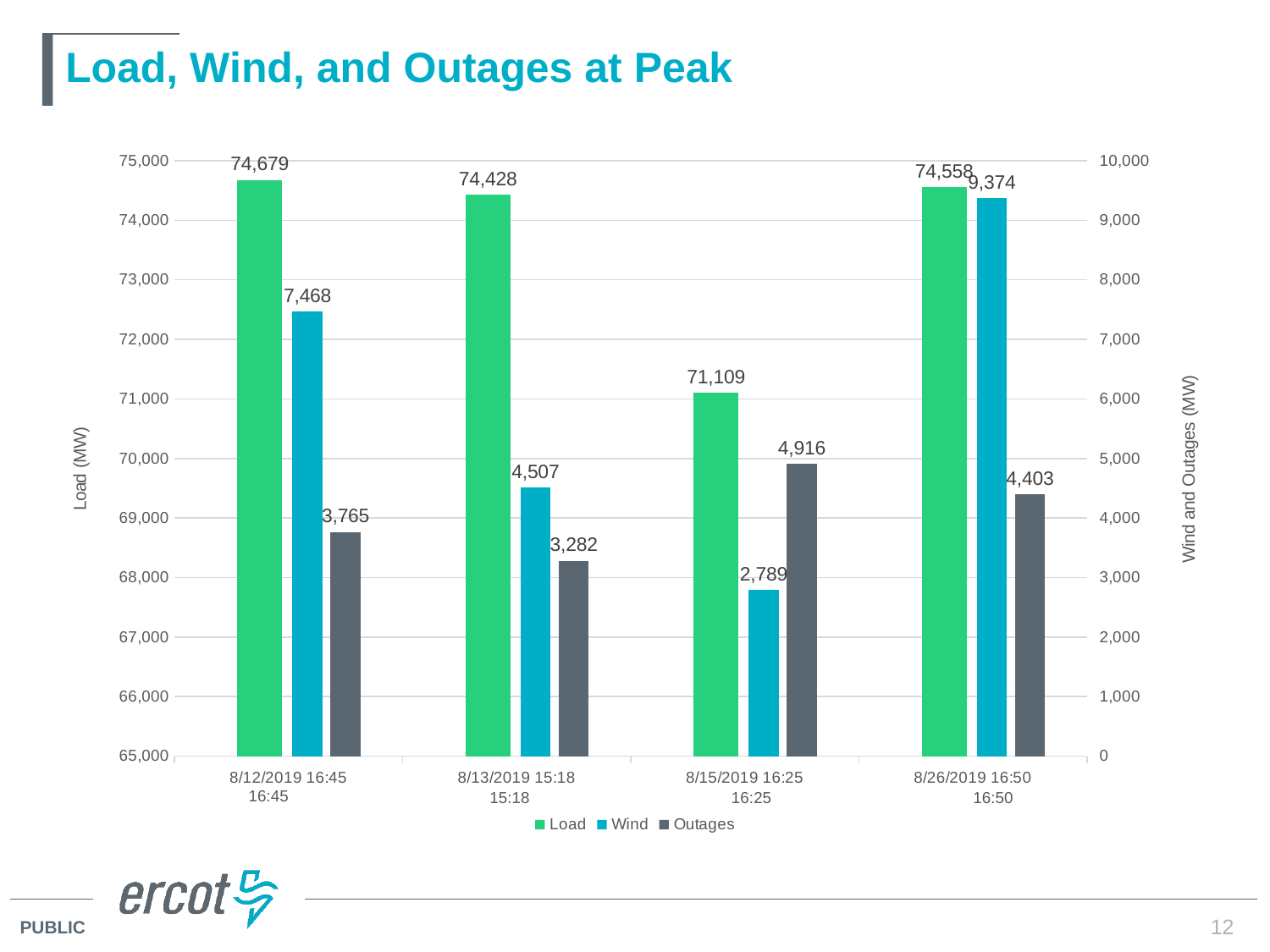
Is the Outages value for 8/12/2019 16:45 larger than the Outages value for 8/13/2019 15:18? Yes What is the Wind value for 8/26/2019 16:50? 9,374 What is the Wind value for 8/13/2019 15:18? 4,507 How many series does the legend list? 3 How many dates are shown on the x axis? 4 Which date has the highest Wind value? 8/26/2019 16:50 Which date has the highest Outages value? 8/15/2019 16:25 What is the Outages value for 8/15/2019 16:25? 4,916 What kind of chart is shown on the slide? Bar chart What is the difference between the Wind values for 8/26/2019 16:50 and 8/15/2019 16:25? 6,585 Which date has the lowest Load value? 8/15/2019 16:25 What is the Load value for 8/12/2019 16:45? 74,679